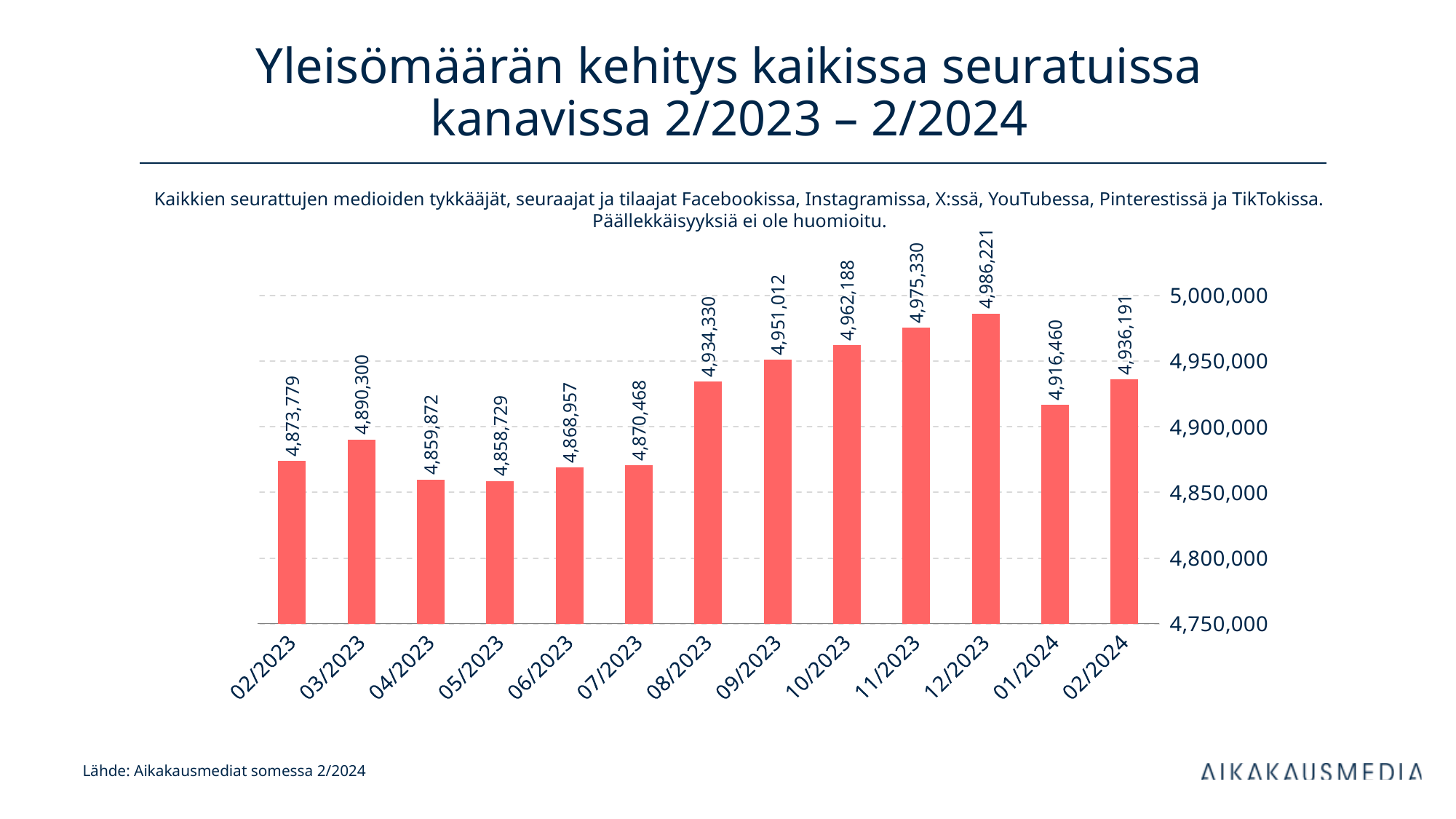
What is the difference between the values for 02/2024 and 02/2023? 62,412 Which month has the highest value? 12/2023 Which is larger, the value for 03/2023 or the value for 07/2023? 03/2023 Which month has the lowest value? 05/2023 Is the value for 01/2024 greater or less than 4,900,000? greater Do the values rise or fall from 08/2023 to 12/2023? rise What kind of chart is shown on the slide? bar chart What is the value for 02/2024? 4,936,191 What is the value for 12/2023? 4,986,221 What is the difference between the values for 12/2023 and 01/2024? 69,761 What is the value for 02/2023? 4,873,779 How many months are shown on the x axis? 13